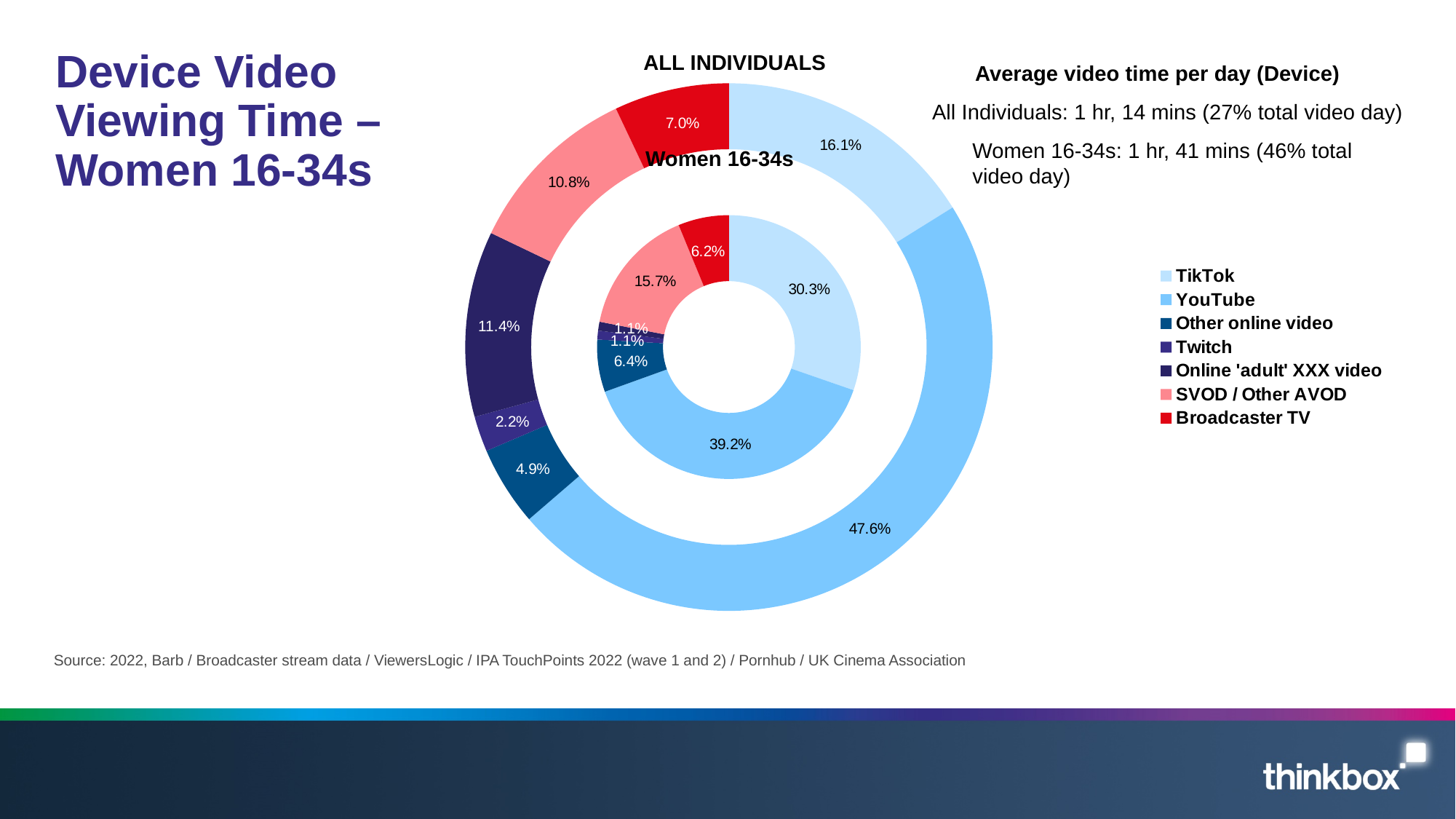
In the All Individuals ring, what share does YouTube have? 47.6% Which is larger: the Broadcaster TV share for All Individuals or for Women 16-34s? All Individuals How many categories does the legend list? 7 Which category has the largest share in the All Individuals ring? YouTube Which category has the smallest share in the All Individuals ring? Twitch What is the average device video time per day for Women 16-34s stated on the slide? 1 hr, 41 mins In the All Individuals ring, what share does Online 'adult' XXX video have? 11.4% In the Women 16-34s ring, what share does TikTok have? 30.3% What type of chart is shown on the slide? Doughnut chart What is the difference between the TikTok share for Women 16-34s and for All Individuals? 14.2% Which category has the largest share in the Women 16-34s ring? YouTube In the Women 16-34s ring, what share does SVOD / Other AVOD have? 15.7%